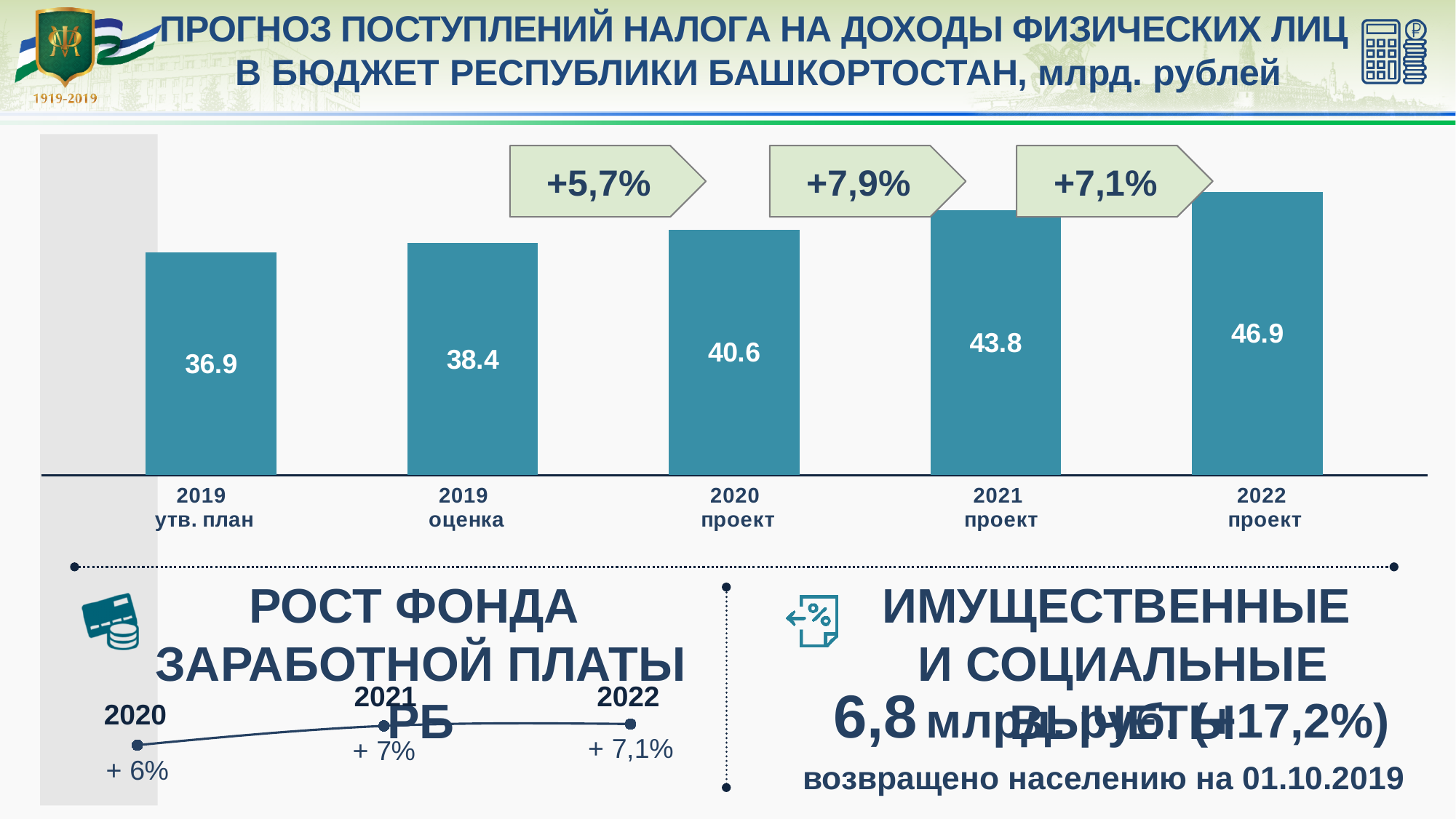
Which category has the highest value in the bar chart? 2022 проект What is the value for 2022 проект in the bar chart? 46.9 What is the difference between the values for 2022 проект and 2021 проект in the bar chart? 3.1 What is the value for 2019 утв. план in the bar chart? 36.9 What type of chart is used to show the forecast of personal income tax receipts? bar chart Do the values in the bar chart rise or fall from left to right? rise How many bars are shown in the bar chart of personal income tax receipts? 5 Which is larger in the bar chart: the value for 2019 оценка or the value for 2020 проект? 2020 проект Which category has the lowest value in the bar chart? 2019 утв. план What growth percentage is shown in the arrow between 2020 проект and 2021 проект? +7,9% What is the value for 2019 оценка in the bar chart? 38.4 What is the value for 2020 проект in the bar chart? 40.6